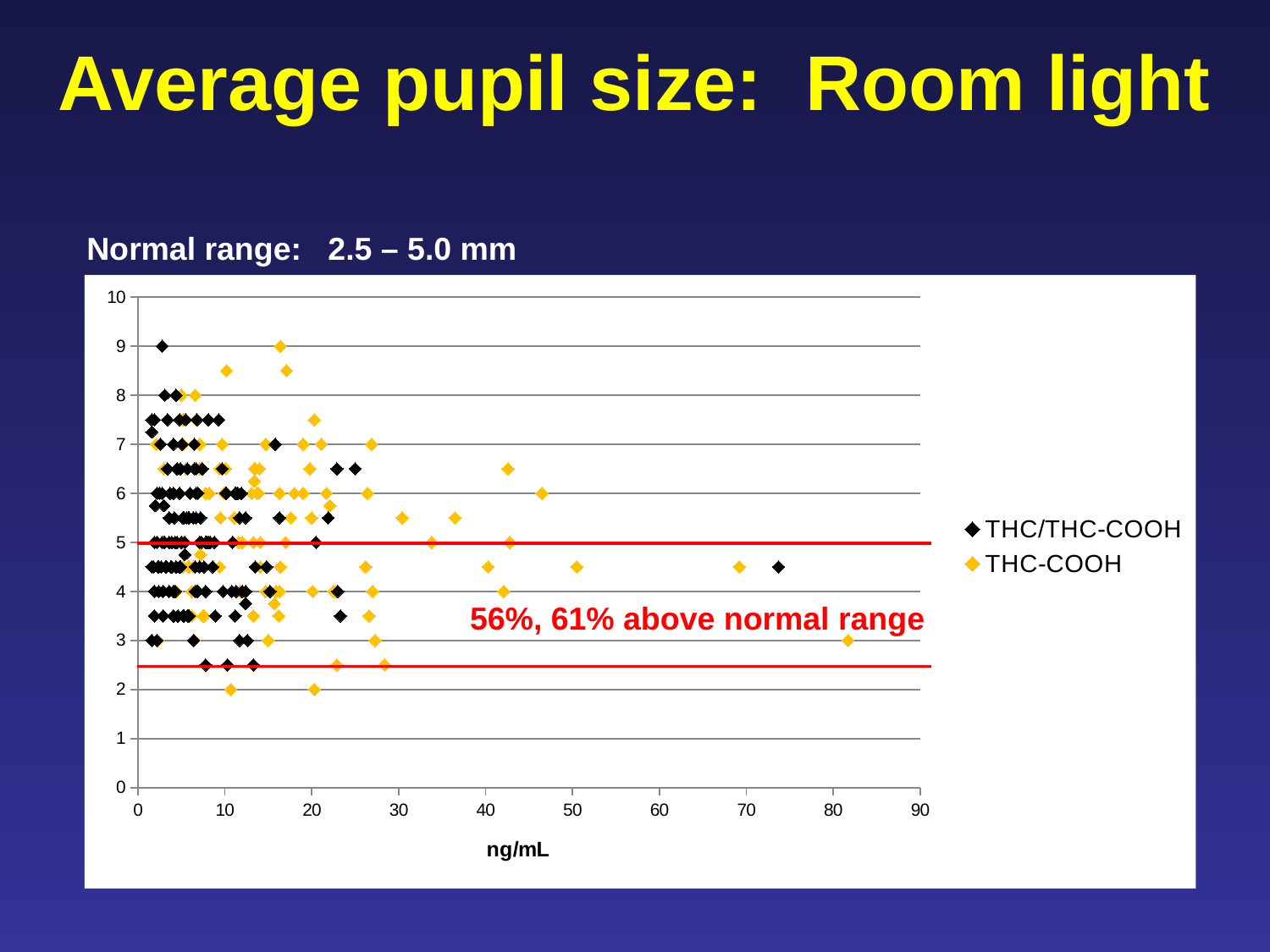
Which series contains the point with the lowest pupil size? THC-COOH Is the highest THC-COOH point's pupil size greater or less than 8? greater Is the ng/mL value of the rightmost THC/THC-COOH point greater or less than 70? greater What are the two series named in the legend? THC/THC-COOH and THC-COOH Is the highest THC/THC-COOH point's pupil size greater or less than 8? greater Which series contains the point with the highest ng/mL value? THC-COOH What kind of chart is shown on the slide? Scatter chart How many series does the legend list? 2 What is the label on the x axis of the chart? ng/mL